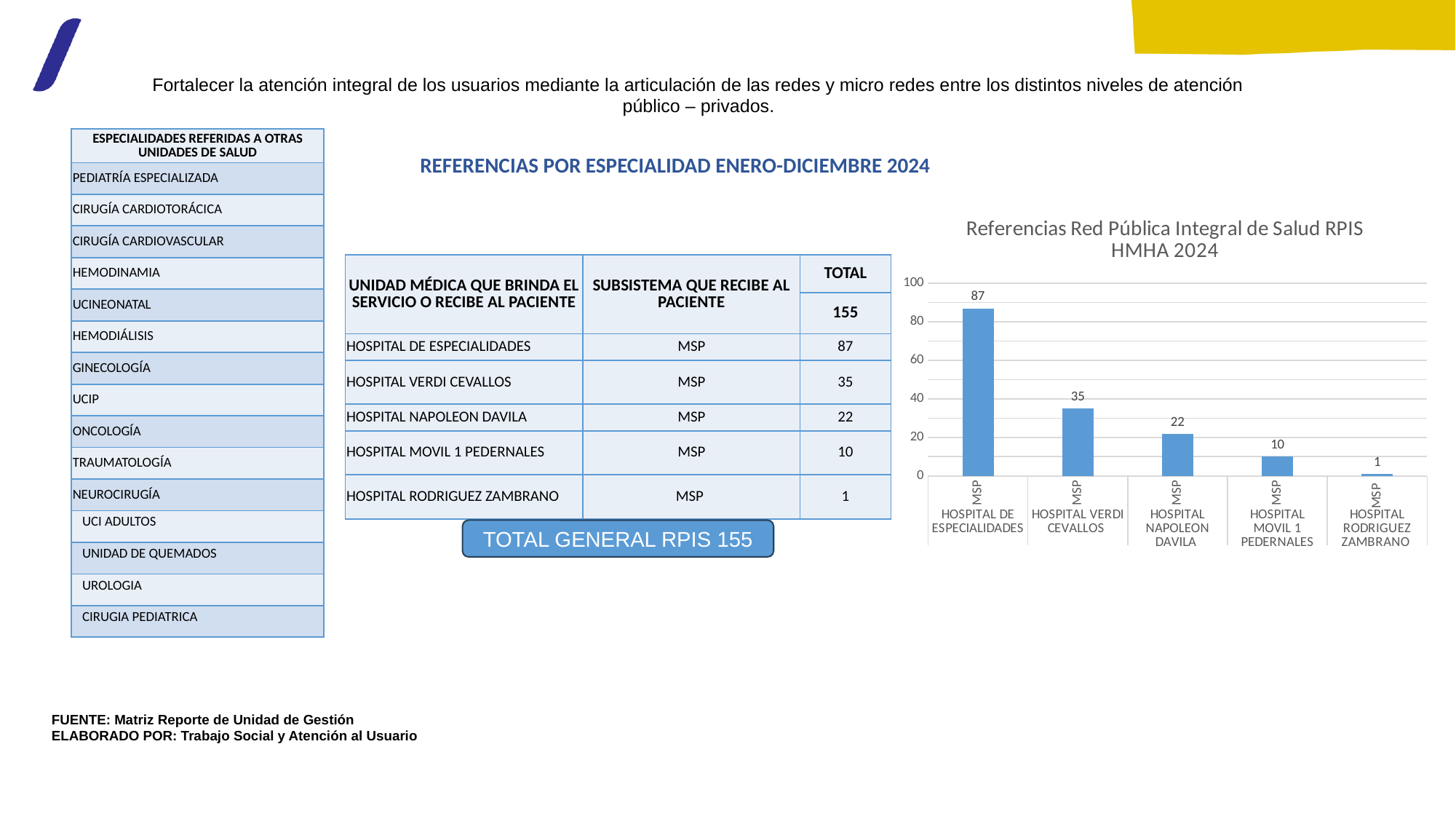
What is the value for HOSPITAL MOVIL 1 PEDERNALES in the chart? 10 Which hospital has the highest value in the chart? HOSPITAL DE ESPECIALIDADES How many hospitals (categories) are shown in the chart? 5 What type of chart is shown on the slide? bar chart What is the value for HOSPITAL NAPOLEON DAVILA in the chart? 22 What is the title of the chart? Referencias Red Pública Integral de Salud RPIS HMHA 2024 Which is larger, the value for HOSPITAL NAPOLEON DAVILA or HOSPITAL MOVIL 1 PEDERNALES? HOSPITAL NAPOLEON DAVILA What is the value for HOSPITAL DE ESPECIALIDADES in the chart? 87 What is the value for HOSPITAL VERDI CEVALLOS in the chart? 35 Which hospital has the lowest value in the chart? HOSPITAL RODRIGUEZ ZAMBRANO Do the values rise or fall from left to right along the x axis? fall What is the difference between the values for HOSPITAL DE ESPECIALIDADES and HOSPITAL VERDI CEVALLOS? 52